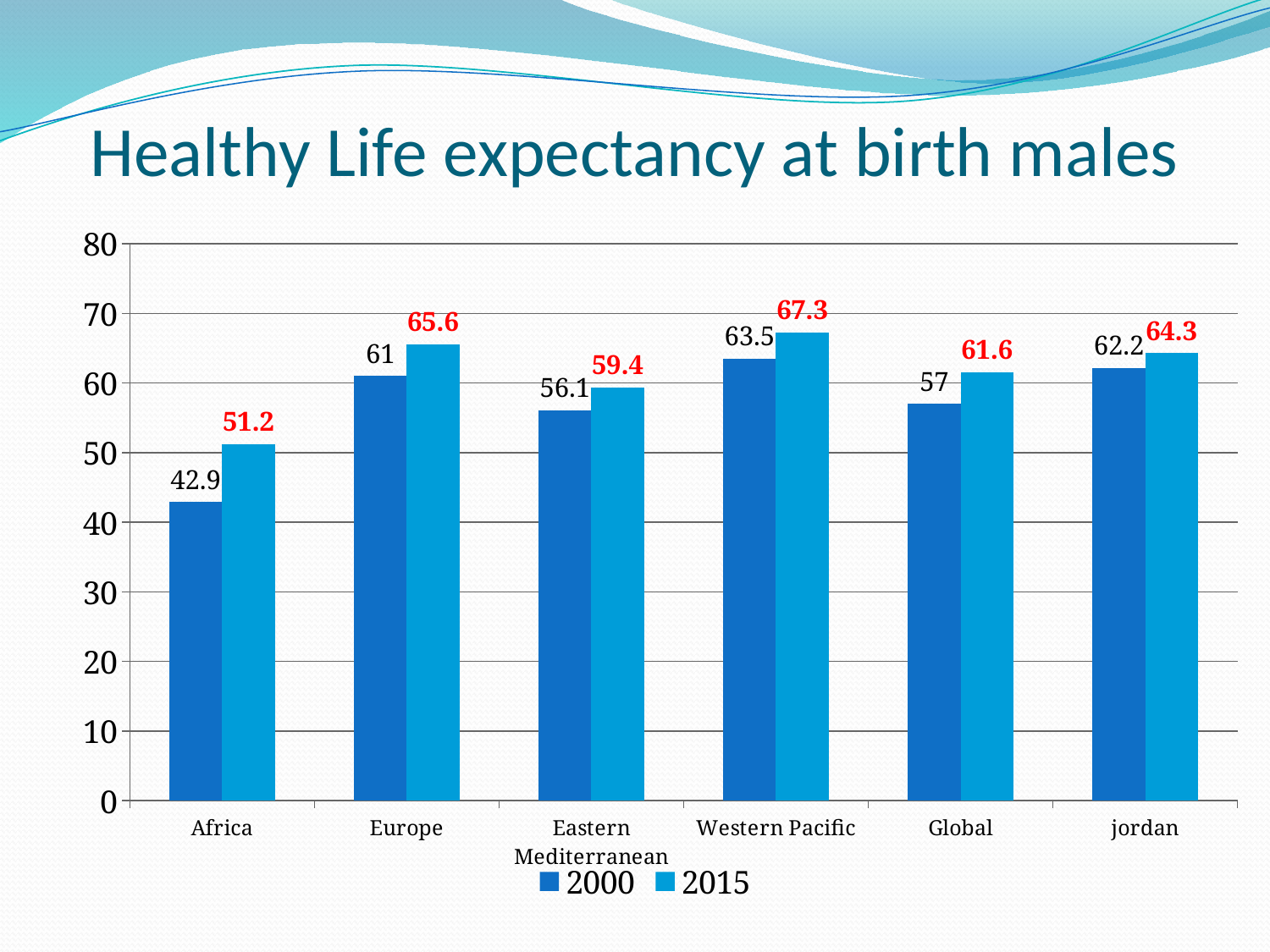
Which is larger, the 2000 value for Global or the 2000 value for Eastern Mediterranean? Global What is the difference between the 2015 and 2000 values for Africa? 8.3 What is the difference between the 2015 and 2000 values for Europe? 4.6 What is the 2000 value for Western Pacific? 63.5 Which category has the lowest 2000 value? Africa What kind of chart is shown on the slide? Bar chart How many categories are shown on the x axis? 6 What is the 2015 value for jordan? 64.3 What is the title of the chart? Healthy Life expectancy at birth males Which category has the highest 2015 value? Western Pacific What is the 2015 value for Africa? 51.2 How many series does the legend list? 2